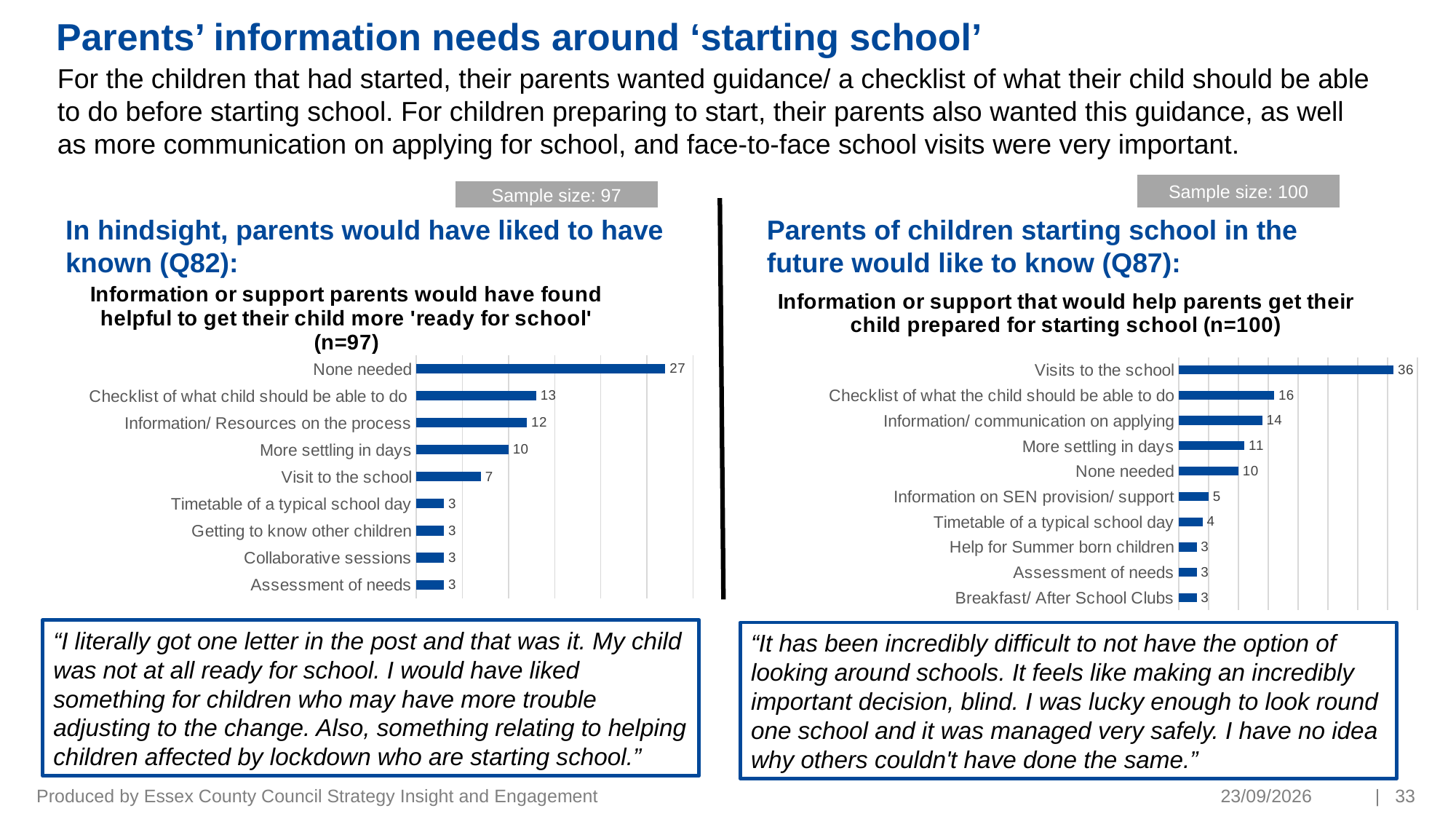
In the right chart (n=100), which category has the highest value? Visits to the school In the left chart (n=97), what is the value for 'None needed'? 27 In the right chart (n=100), what is the difference between 'Visits to the school' and 'Checklist of what the child should be able to do'? 20 In the left chart (n=97), what is the difference between 'None needed' and 'Checklist of what child should be able to do'? 14 In the left chart (n=97), what is the value for 'More settling in days'? 10 How many categories are shown in the left chart (n=97)? 9 What type of chart is the right chart (n=100)? Bar chart In the right chart (n=100), which is larger: 'More settling in days' or 'None needed'? More settling in days In the left chart (n=97), which category has the highest value? None needed How many categories are shown in the right chart (n=100)? 10 In the right chart (n=100), what is the value for 'Information on SEN provision/ support'? 5 In the right chart (n=100), what is the value for 'Visits to the school'? 36